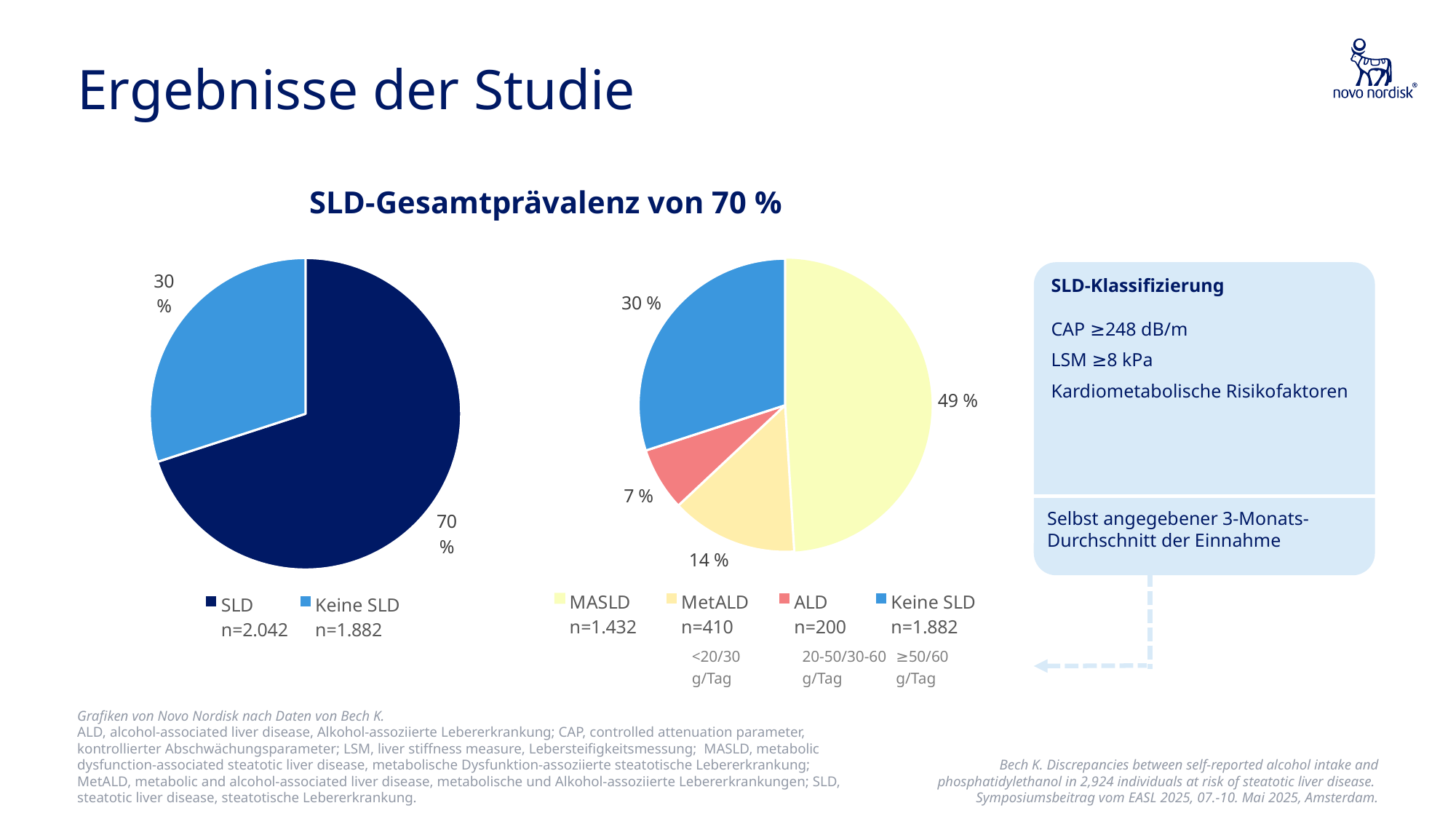
In the right pie chart, which slice is larger, MetALD or ALD? MetALD In the left pie chart, what share is labelled for Keine SLD? 30 % In the right pie chart, what is the difference in percentage points between MASLD and Keine SLD? 19 In the right pie chart, what share is labelled for MASLD? 49 % What is the title shown above the two pie charts? SLD-Gesamtprävalenz von 70 % In the left pie chart, what share is labelled for SLD? 70 % In the right pie chart, which category has the smallest slice? ALD How many categories does the legend of the right pie chart list? 4 In the right pie chart, what share is labelled for ALD? 7 % In the right pie chart, which category has the largest slice? MASLD What type of chart is the left chart? Pie chart In the right pie chart's legend, what n value is given for MetALD? n=410